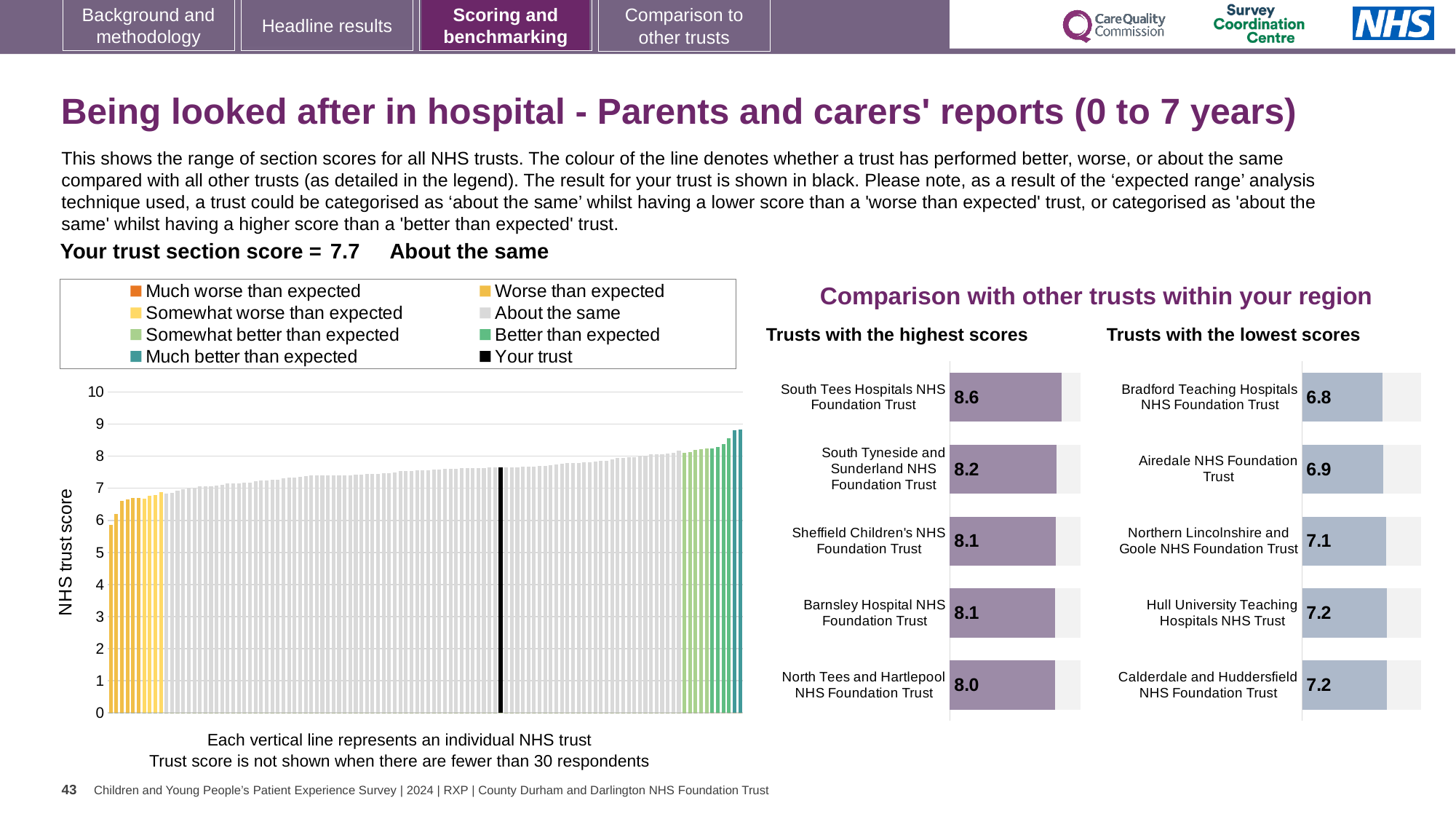
In the 'Trusts with the lowest scores' chart, what is the score for Bradford Teaching Hospitals NHS Foundation Trust? 6.8 In the large chart on the left showing NHS trust scores, how many entries does the legend list? 8 In the 'Trusts with the highest scores' chart, what is the difference between the scores of South Tees Hospitals NHS Foundation Trust and North Tees and Hartlepool NHS Foundation Trust? 0.6 In the 'Trusts with the highest scores' chart, how many trusts are shown? 5 In the 'Trusts with the lowest scores' chart, what is the difference between the scores of Hull University Teaching Hospitals NHS Trust and Bradford Teaching Hospitals NHS Foundation Trust? 0.4 In the large chart on the left showing NHS trust scores, do the values rise or fall from left to right? Rise In the 'Trusts with the lowest scores' chart, which trust has the lowest score? Bradford Teaching Hospitals NHS Foundation Trust In the 'Trusts with the highest scores' chart, what is the score for South Tees Hospitals NHS Foundation Trust? 8.6 In the 'Trusts with the highest scores' chart, what is the score for North Tees and Hartlepool NHS Foundation Trust? 8.0 In the 'Trusts with the highest scores' chart, which trust has the highest score? South Tees Hospitals NHS Foundation Trust In the large chart on the left showing NHS trust scores, what kind of chart is it? Bar chart In the 'Trusts with the lowest scores' chart, which has the larger score: Airedale NHS Foundation Trust or Northern Lincolnshire and Goole NHS Foundation Trust? Northern Lincolnshire and Goole NHS Foundation Trust